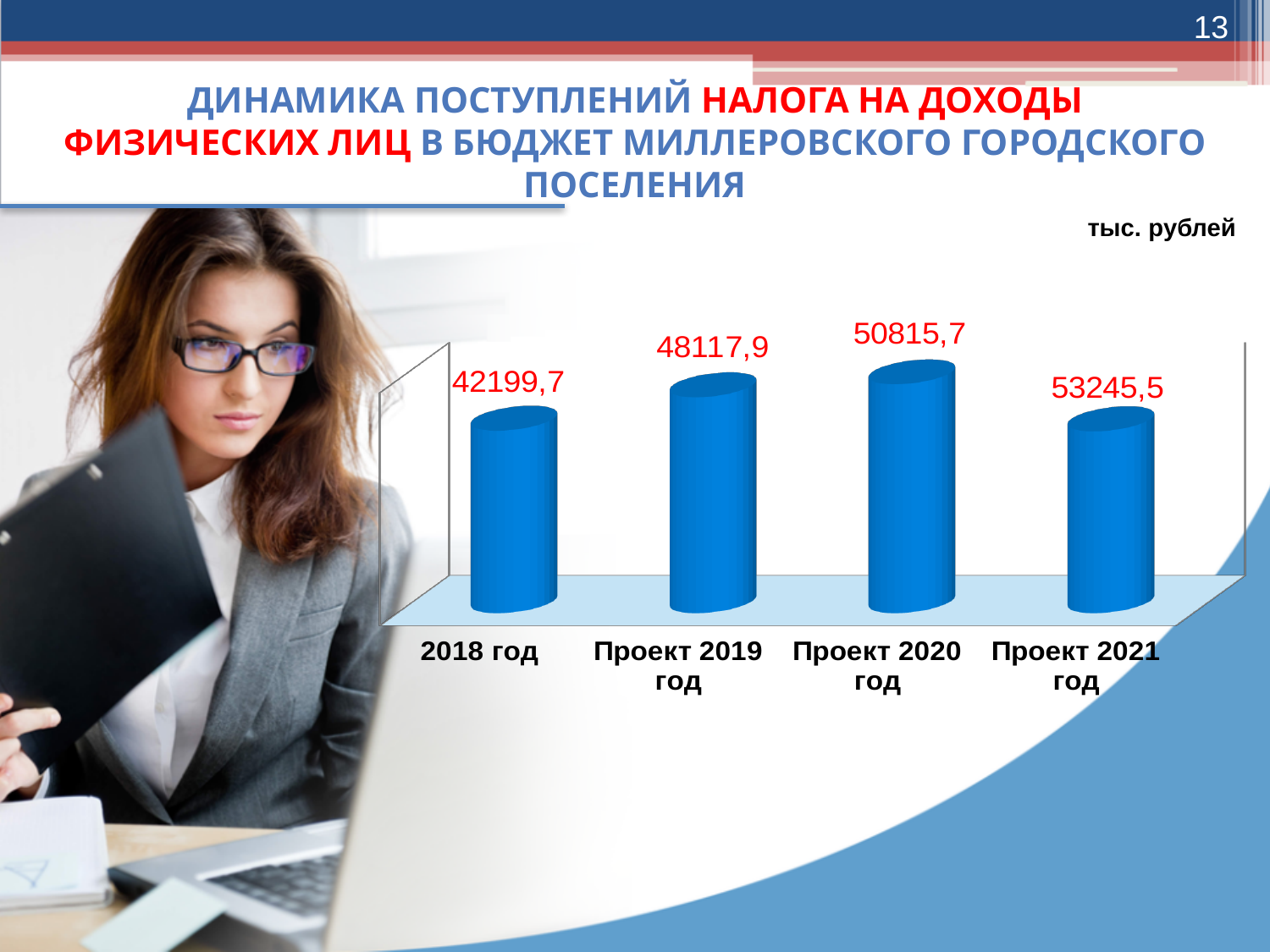
What is the difference between the values for Проект 2021 год and 2018 год? 11045,8 What is the value for Проект 2020 год? 50815,7 Which category has the highest value according to the data labels? Проект 2021 год What is the value for Проект 2019 год? 48117,9 What is the value for 2018 год? 42199,7 What is the difference between the values for Проект 2019 год and 2018 год? 5918,2 What kind of chart is shown on the slide? Bar chart In what units are the chart values given? тыс. рублей How many categories are shown on the chart? 4 Which is larger according to the data labels: the value for Проект 2020 год or Проект 2019 год? Проект 2020 год What is the value for Проект 2021 год? 53245,5 Which category has the lowest value? 2018 год